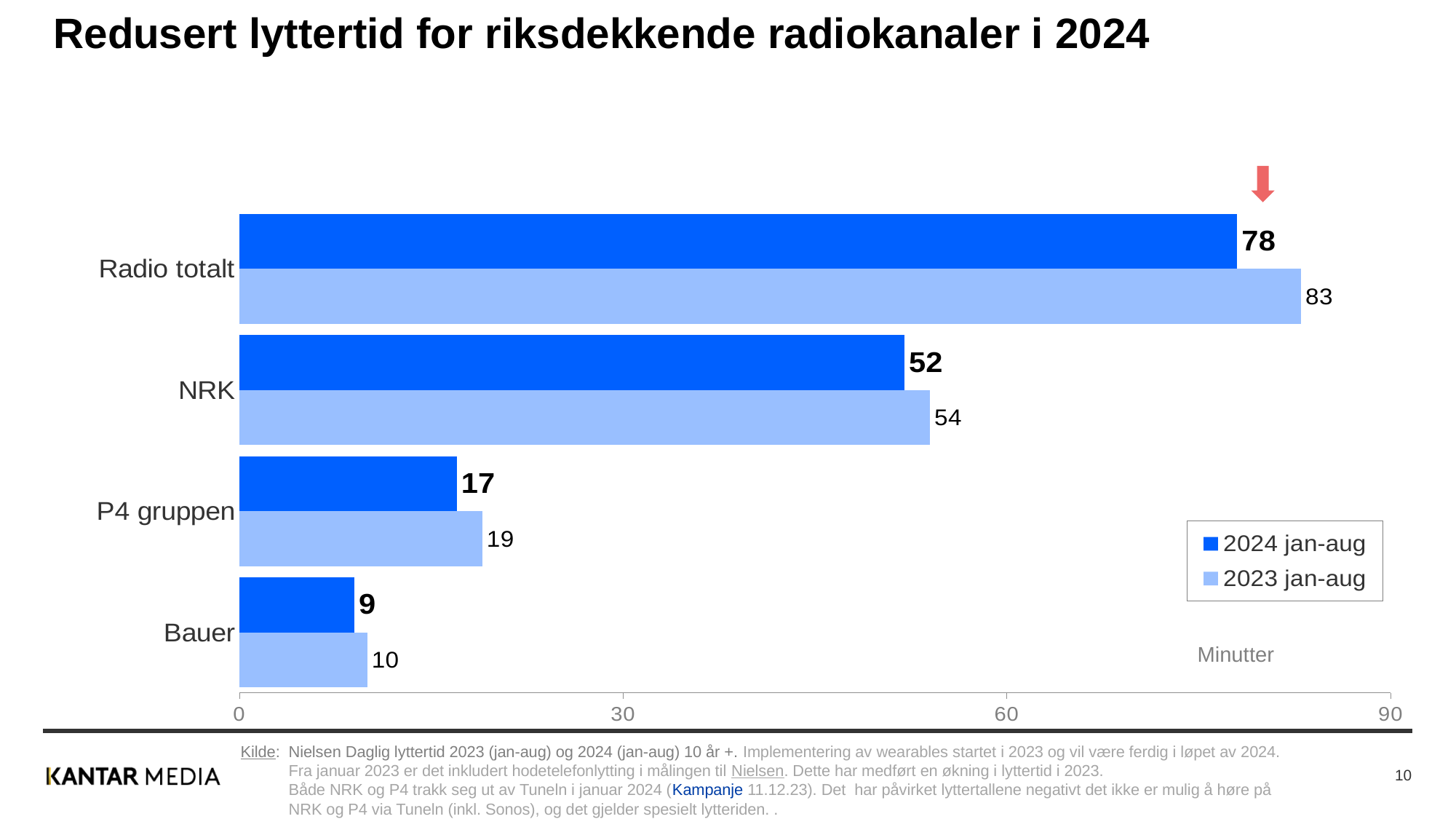
What is the value for Radio totalt in the 2024 jan-aug series? 78 What is the value for NRK in the 2023 jan-aug series? 54 What is the value for Bauer in the 2023 jan-aug series? 10 What kind of chart is shown on the slide? Bar chart What is the value for P4 gruppen in the 2024 jan-aug series? 17 Which category has the lowest value in the 2024 jan-aug series? Bauer How many categories are shown on the chart? 4 What is the difference between the 2023 jan-aug and 2024 jan-aug values for NRK? 2 Which category has the highest value in the 2023 jan-aug series? Radio totalt What is the difference between the 2023 jan-aug and 2024 jan-aug values for Radio totalt? 5 Which is larger for P4 gruppen: the 2024 jan-aug value or the 2023 jan-aug value? 2023 jan-aug How many series does the legend list? 2